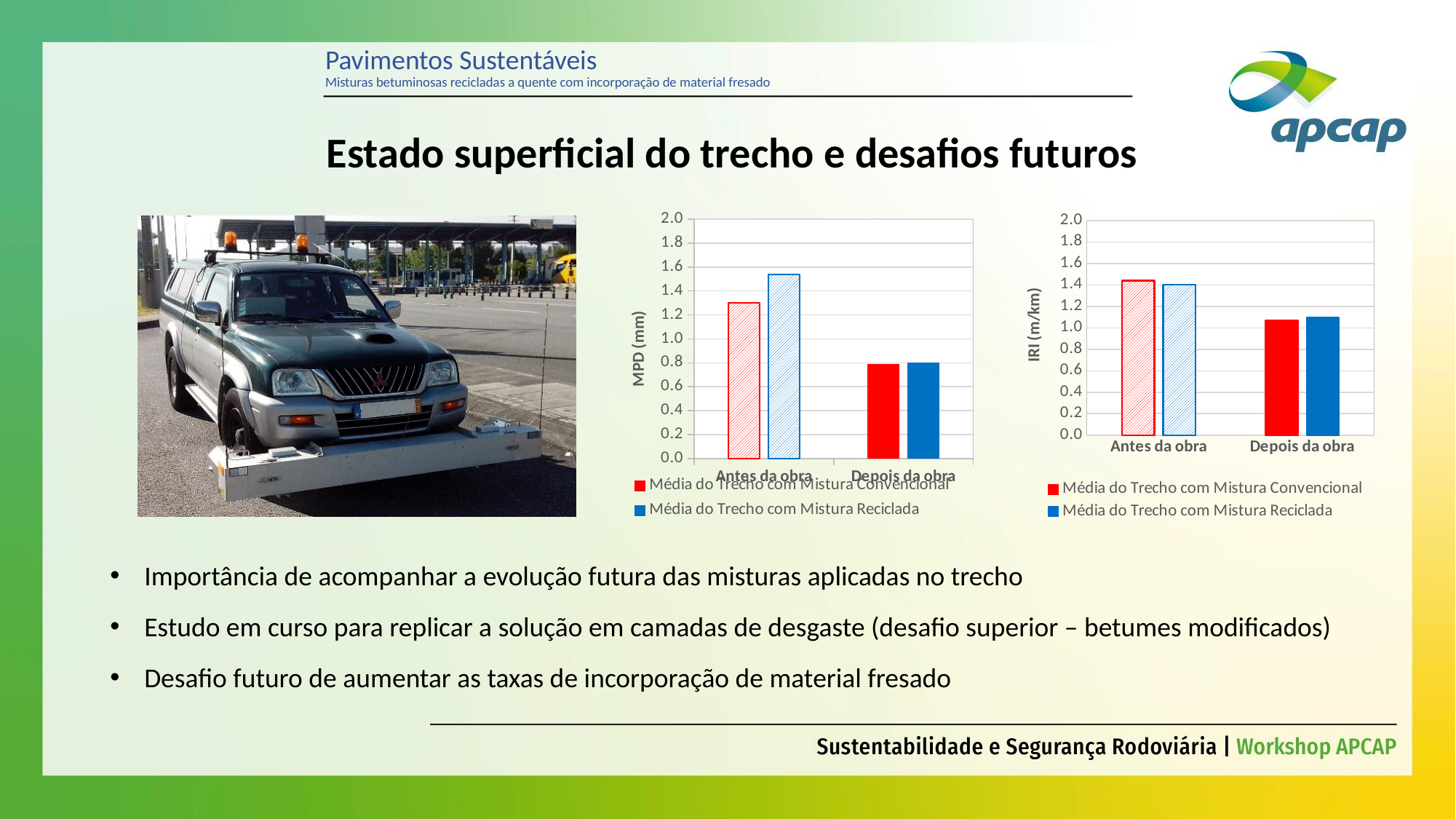
In the MPD (mm) chart, is the value for Média do Trecho com Mistura Reciclada at Antes da obra greater or less than 1.4? greater In the IRI (m/km) chart, do the values for Média do Trecho com Mistura Convencional rise or fall from Antes da obra to Depois da obra? fall What kind of chart is the MPD (mm) chart? bar chart What is the y-axis title of the chart on the right? IRI (m/km) In the IRI (m/km) chart, is the value for Média do Trecho com Mistura Reciclada at Depois da obra greater or less than 1.2? less How many categories are shown on the x axis of the MPD (mm) chart? 2 In the IRI (m/km) chart, is the value for Média do Trecho com Mistura Convencional at Antes da obra greater or less than 1.2? greater In the MPD (mm) chart, which series has the larger value at Antes da obra? Média do Trecho com Mistura Reciclada How many series does the legend of the IRI (m/km) chart list? 2 In the MPD (mm) chart, do the values for Média do Trecho com Mistura Reciclada rise or fall from Antes da obra to Depois da obra? fall